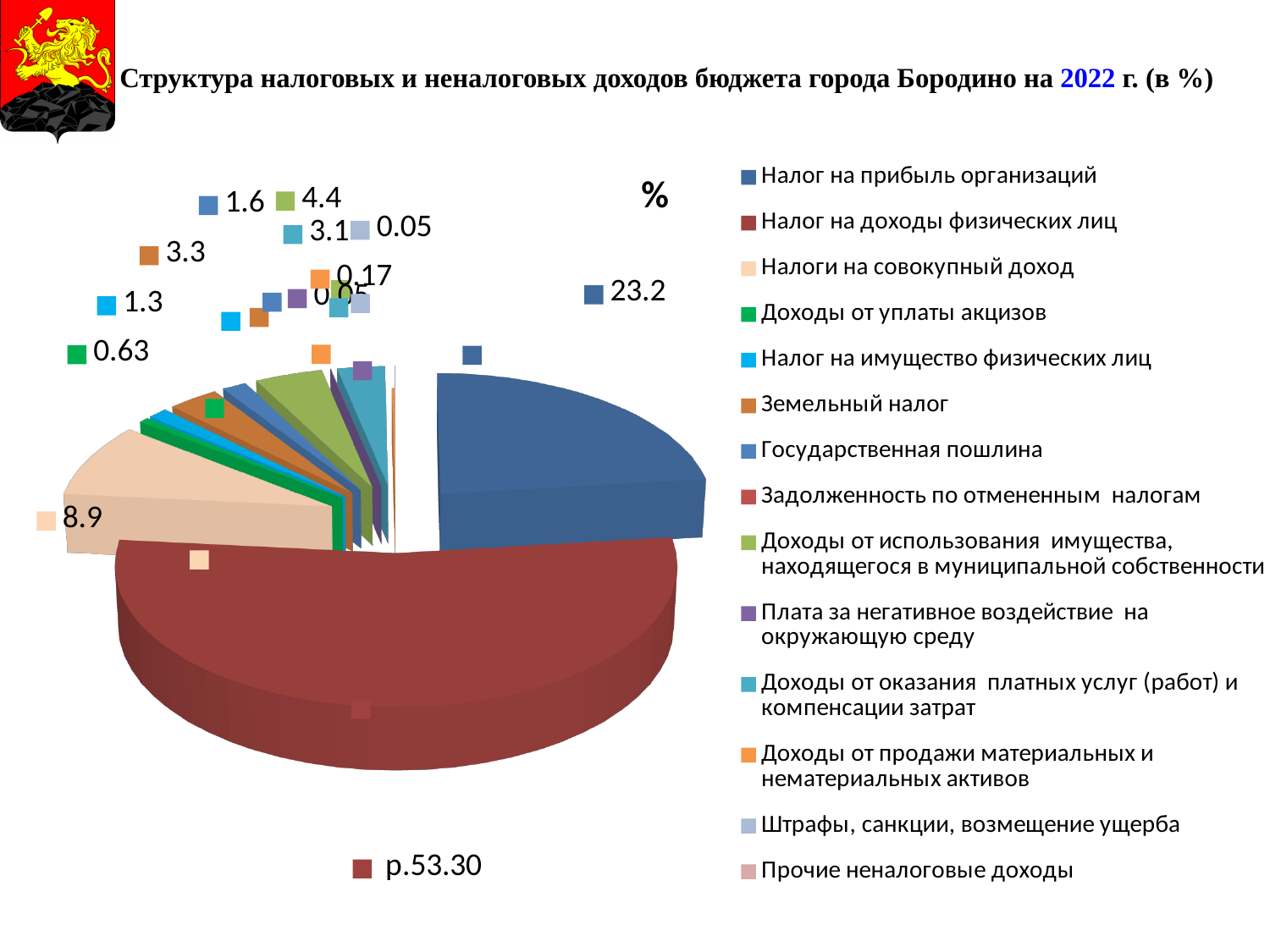
What is the value shown for Доходы от оказания платных услуг (работ) и компенсации затрат? 3.1 Which year does the chart title say the data refers to? 2022 What is the value shown for Доходы от использования имущества, находящегося в муниципальной собственности? 4.4 Which is larger: Налог на прибыль организаций or Налоги на совокупный доход? Налог на прибыль организаций What is the difference between the values for Налог на прибыль организаций and Налоги на совокупный доход? 14.3 What is the value shown for Налог на прибыль организаций? 23.2 What is the value shown for Земельный налог? 3.3 What is the value shown for Государственная пошлина? 1.6 What is the value shown for Налоги на совокупный доход? 8.9 How many entries does the legend of the pie chart list? 14 Which category has the largest slice of the pie? Налог на доходы физических лиц What kind of chart is shown on the slide? pie chart